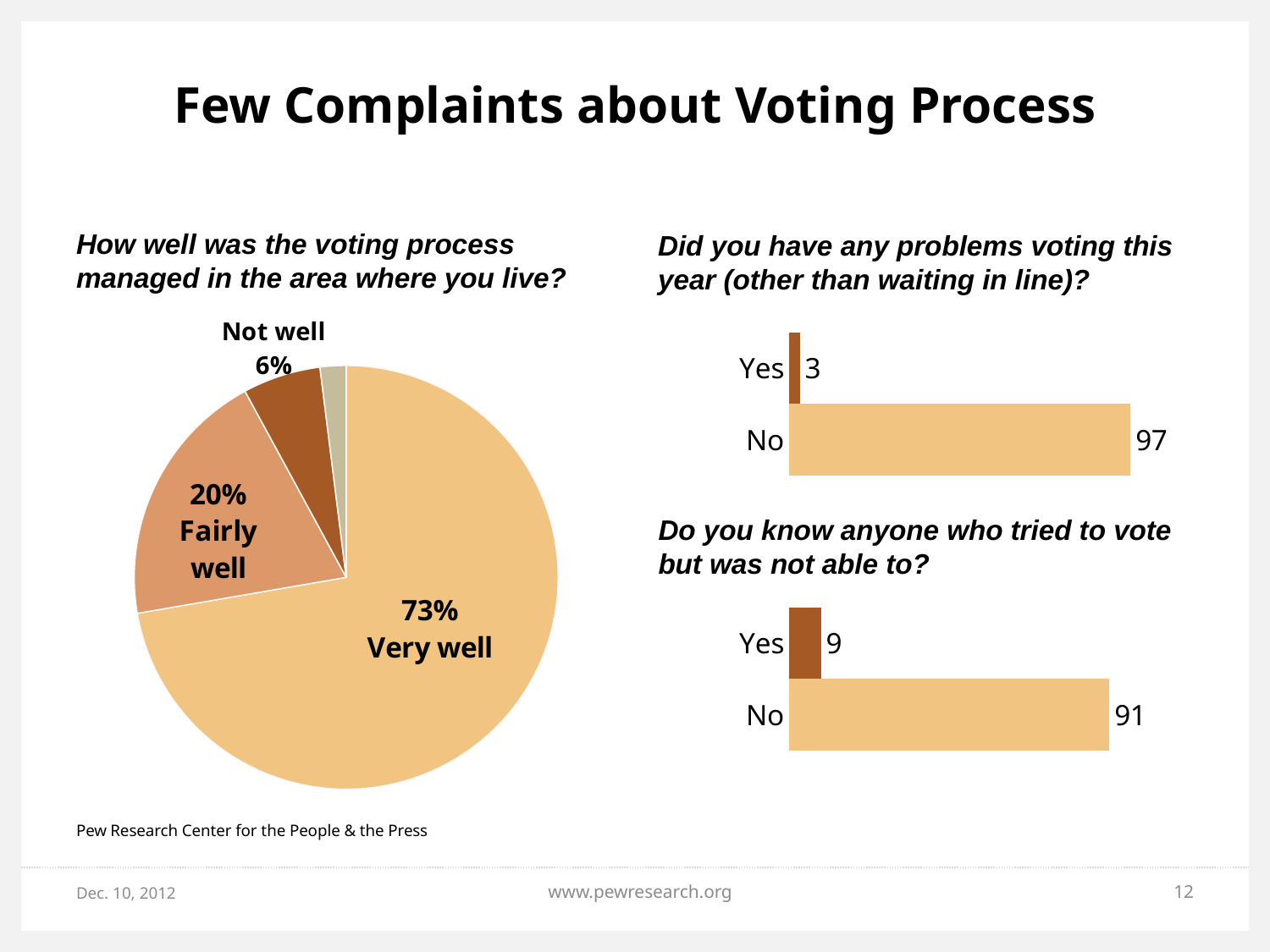
In the pie chart 'How well was the voting process managed in the area where you live?', which response has the largest slice? Very well In the chart 'Did you have any problems voting this year (other than waiting in line)?', what is the value for 'Yes'? 3 In the chart 'Did you have any problems voting this year (other than waiting in line)?', what is the value for 'No'? 97 What kind of chart is used for 'Did you have any problems voting this year (other than waiting in line)?'? Bar chart In the pie chart 'How well was the voting process managed in the area where you live?', what share said 'Fairly well'? 20% In the chart 'Do you know anyone who tried to vote but was not able to?', what is the difference between 'No' and 'Yes'? 82 In the chart 'Do you know anyone who tried to vote but was not able to?', what is the value for 'Yes'? 9 In the pie chart 'How well was the voting process managed in the area where you live?', what share said 'Not well'? 6% What kind of chart is used for 'How well was the voting process managed in the area where you live?'? Pie chart Which is larger: the 'Yes' value in 'Did you have any problems voting this year' or the 'Yes' value in 'Do you know anyone who tried to vote but was not able to?'? Do you know anyone who tried to vote but was not able to? (9) In the pie chart 'How well was the voting process managed in the area where you live?', what share said 'Very well'? 73% In the pie chart 'How well was the voting process managed in the area where you live?', how many percentage points larger is 'Very well' than 'Fairly well'? 53 percentage points